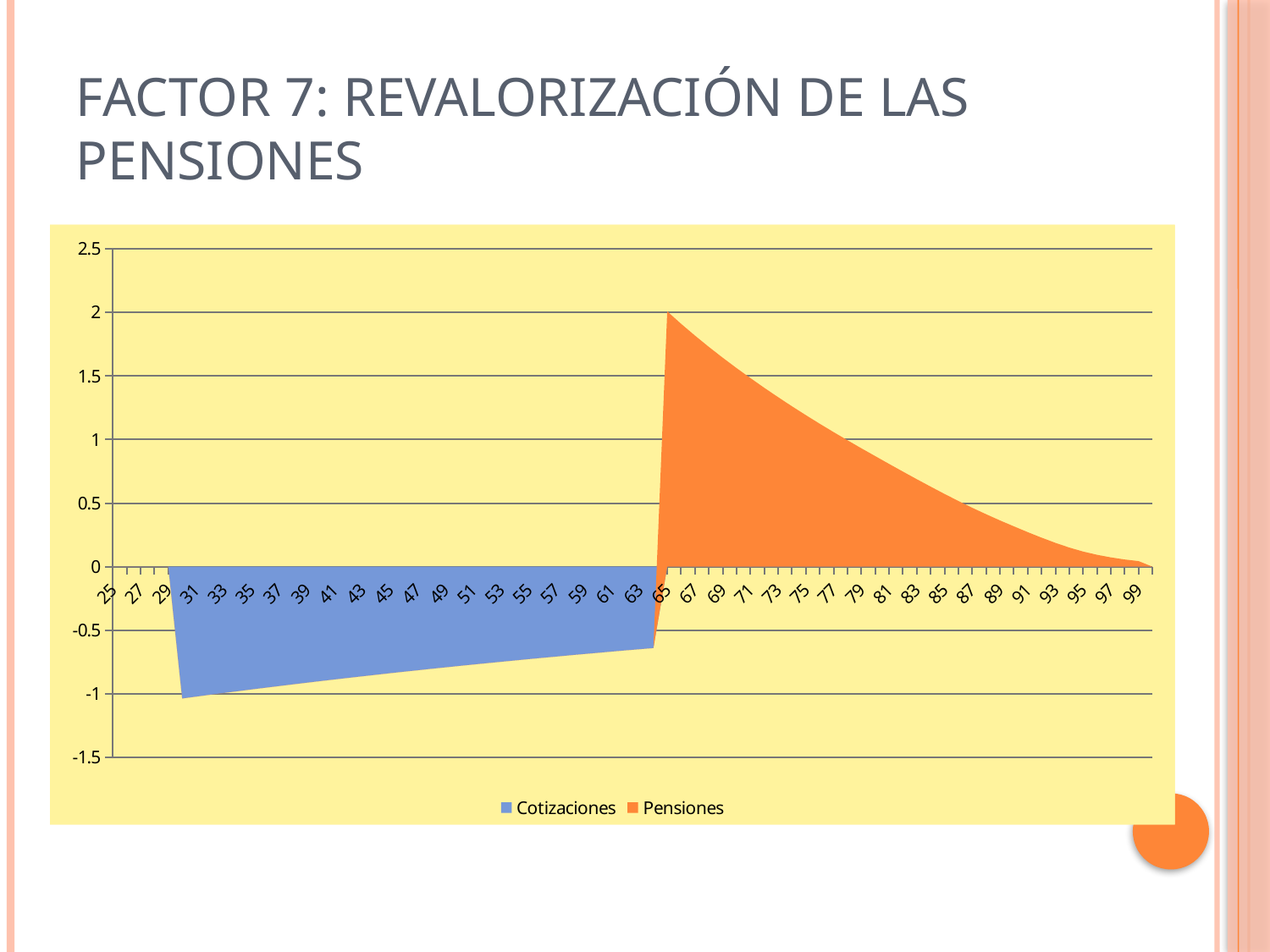
Which series has negative values? Cotizaciones Is the Pensiones value at age 65 greater or less than 1.5? greater Is the Cotizaciones value at age 45 greater or less than -1? greater Which series is shown in blue? Cotizaciones Do the Pensiones values rise or fall as age increases from 65 to 99? Fall Is the Pensiones value at age 73 greater or less than 1? greater Which series is shown in orange? Pensiones At which age does the Pensiones series reach its highest value? 65 How many series does the legend list? 2 What kind of chart is shown on the slide? Area chart